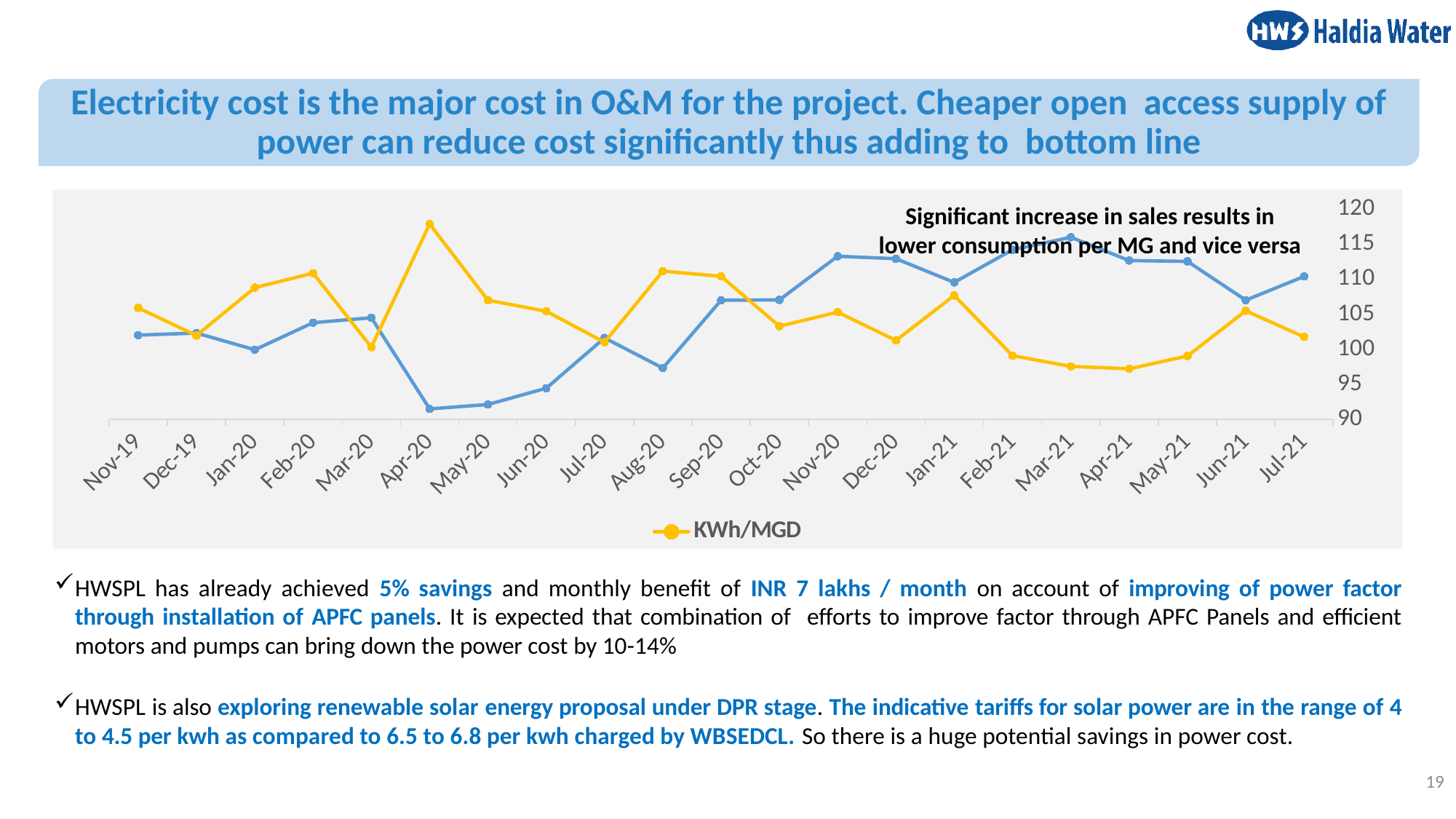
Is the KWh/MGD value for Feb-20 greater or less than 105? greater Is the KWh/MGD value for Jul-20 greater or less than 105? less Is the KWh/MGD value for Mar-21 greater or less than 100? less Which month has the higher KWh/MGD value, Jan-21 or Feb-21? Jan-21 Which month has the higher KWh/MGD value, Mar-20 or Apr-20? Apr-20 What kind of chart is shown on the slide? line chart How many series does the chart legend list? 1 Does the KWh/MGD series rise or fall from Jan-21 to Apr-21? fall How many months are plotted along the x axis of the chart? 21 In which month does the KWh/MGD series reach its highest value? Apr-20 What is the series name shown in the chart legend? KWh/MGD